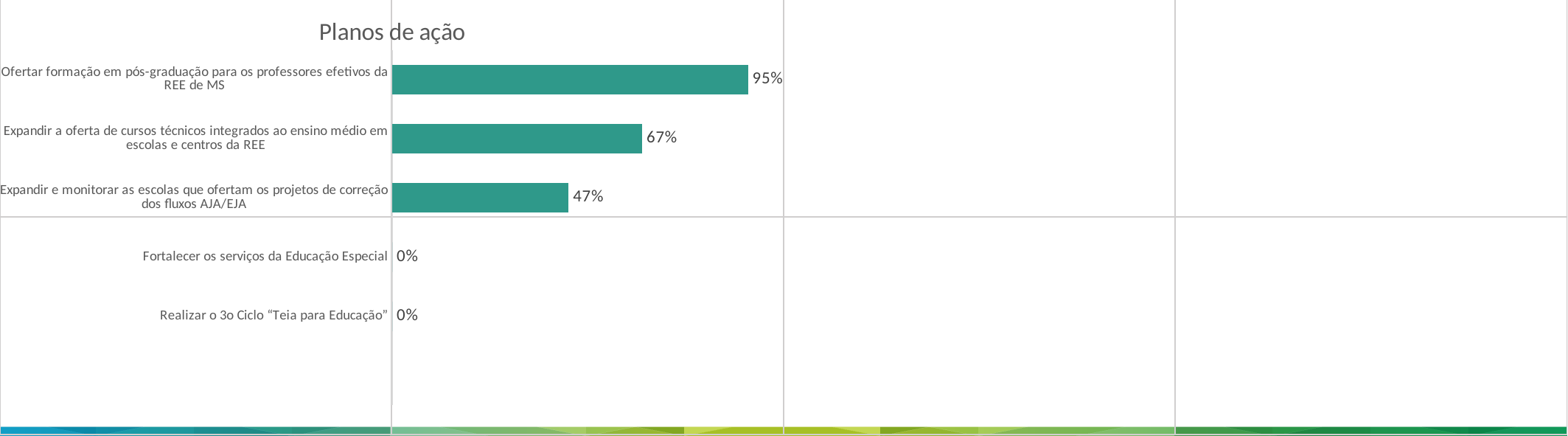
How many categories are shown in the chart? 5 Which category has the highest value? Ofertar formação em pós-graduação para os professores efetivos da REE de MS What is the value for 'Expandir a oferta de cursos técnicos integrados ao ensino médio em escolas e centros da REE'? 67% How many categories have a value of 0%? 2 What kind of chart is shown on the slide? Bar chart What is the title of the chart? Planos de ação What is the value for 'Expandir e monitorar as escolas que ofertam os projetos de correção dos fluxos AJA/EJA'? 47% What is the difference between the values for 'Ofertar formação em pós-graduação para os professores efetivos da REE de MS' and 'Expandir a oferta de cursos técnicos integrados ao ensino médio em escolas e centros da REE'? 28% What is the value for 'Fortalecer os serviços da Educação Especial'? 0% What is the value for 'Ofertar formação em pós-graduação para os professores efetivos da REE de MS'? 95% Which is larger: the value for 'Expandir a oferta de cursos técnicos integrados ao ensino médio em escolas e centros da REE' or for 'Expandir e monitorar as escolas que ofertam os projetos de correção dos fluxos AJA/EJA'? Expandir a oferta de cursos técnicos integrados ao ensino médio em escolas e centros da REE What is the difference between the values for 'Expandir a oferta de cursos técnicos integrados ao ensino médio em escolas e centros da REE' and 'Expandir e monitorar as escolas que ofertam os projetos de correção dos fluxos AJA/EJA'? 20%